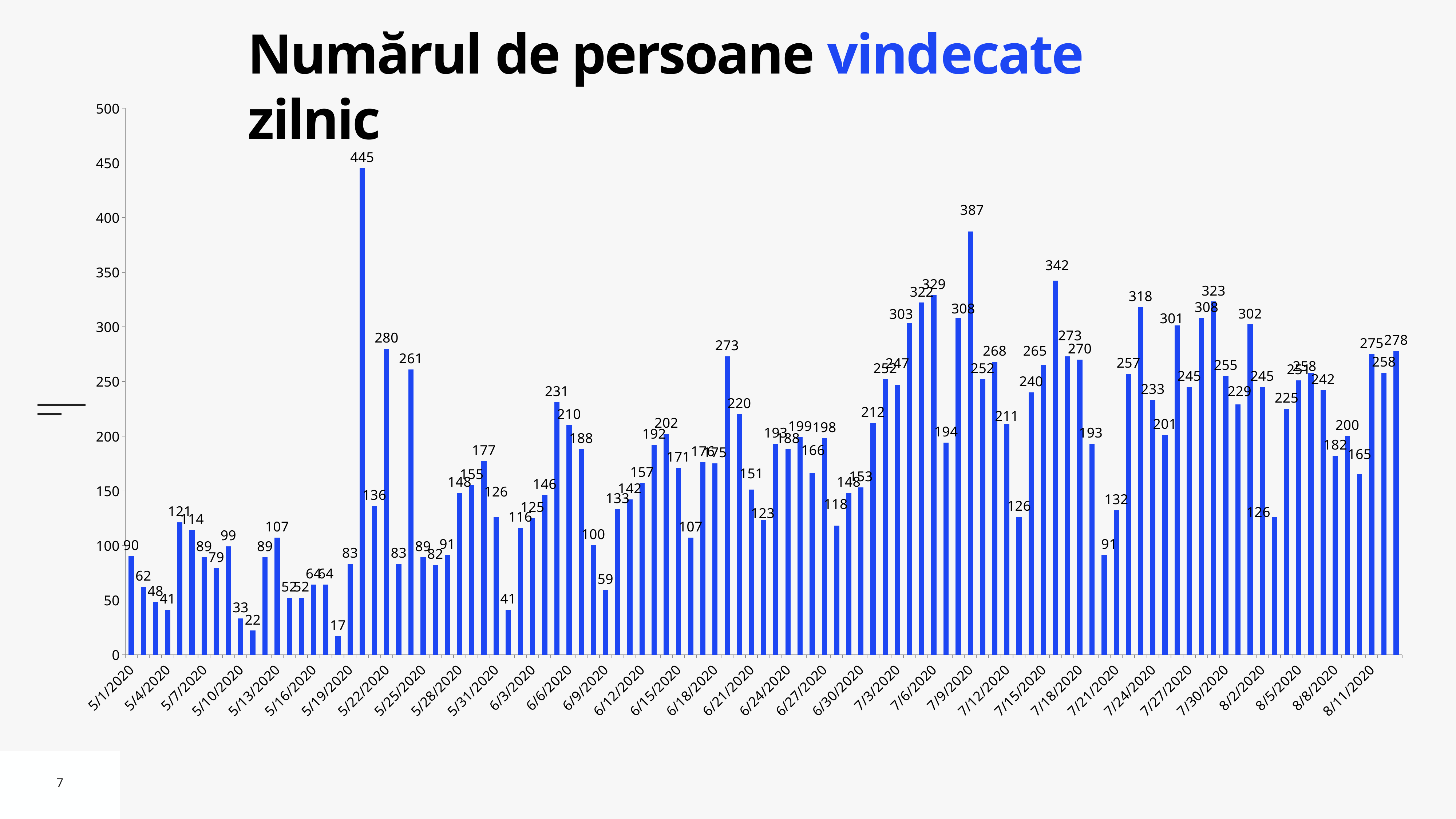
Do the daily values generally rise or fall from May to August along the x axis? rise Which date has the larger value, 5/1/2020 or 7/9/2020? 7/9/2020 What kind of chart is shown on the slide? bar chart What is the value for 5/1/2020? 90 What is the value for 7/21/2020? 132 What is the value for 7/9/2020? 387 Is the value for 7/9/2020 greater or less than 350? greater What is the title of the chart? Numărul de persoane vindecate zilnic What is the value for 5/10/2020? 33 What is the highest daily value shown in the chart? 445 What is the lowest daily value shown in the chart? 17 What is the difference between the highest value (445) and the value for 7/9/2020 (387)? 58